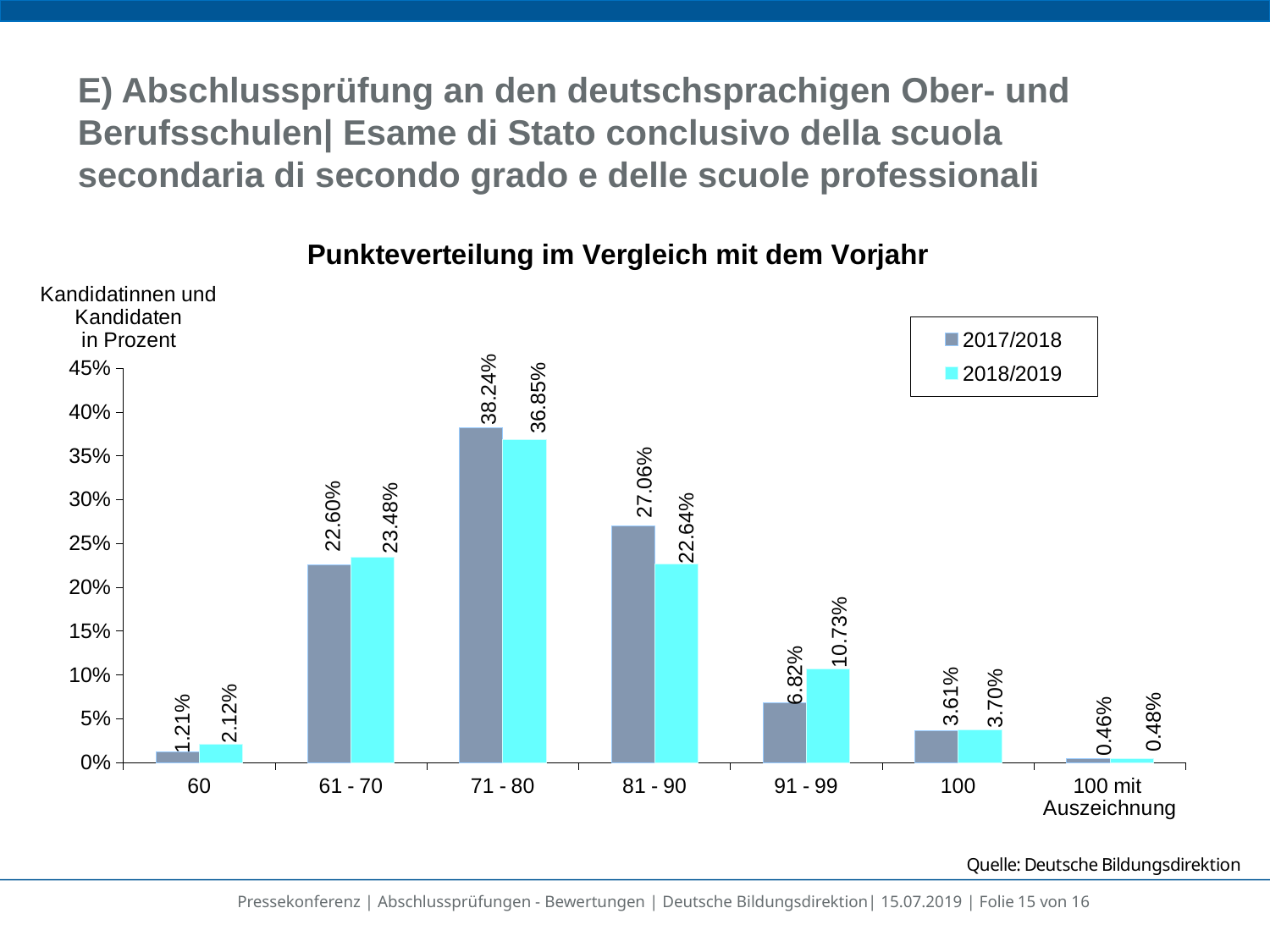
How many categories are shown on the x axis? 7 What is the value for the 71 - 80 category in the 2017/2018 series? 38.24% What is the difference between the 2017/2018 and 2018/2019 values for the 81 - 90 category? 4.42% Which category has the highest value in the 2018/2019 series? 71 - 80 What is the value for the 100 mit Auszeichnung category in the 2017/2018 series? 0.46% Which category has the lowest value in the 2017/2018 series? 100 mit Auszeichnung What is the title of the chart? Punkteverteilung im Vergleich mit dem Vorjahr What kind of chart is shown on the slide? bar chart What is the value for the 91 - 99 category in the 2018/2019 series? 10.73% Is the value for 61 - 70 in the 2018/2019 series greater or less than 20%? greater How many series does the legend list? 2 For the 91 - 99 category, which series has the larger value, 2017/2018 or 2018/2019? 2018/2019